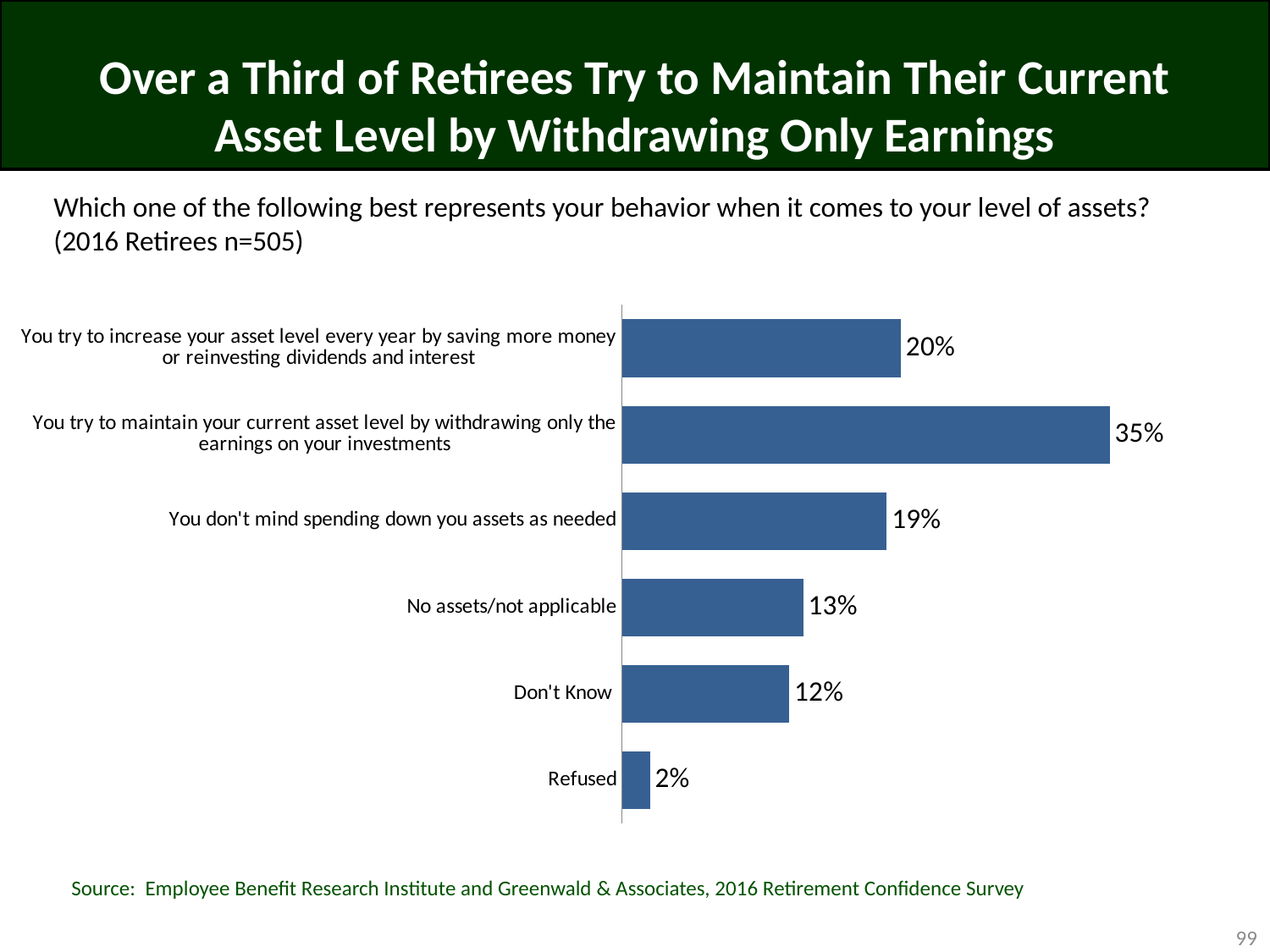
How many response categories are shown in the chart? 6 What percentage of retirees say they try to increase their asset level every year by saving more money or reinvesting dividends and interest? 20% What is the sample size of 2016 retirees stated on the slide? n=505 What percentage of retirees answered 'No assets/not applicable'? 13% Which response has the lowest percentage? Refused What percentage of retirees say they don't mind spending down their assets as needed? 19% Which is larger: the percentage for 'No assets/not applicable' or the percentage for 'Don't Know'? No assets/not applicable What percentage of retirees say they try to maintain their current asset level by withdrawing only the earnings on their investments? 35% What percentage of retirees answered 'Refused'? 2% What is the difference in percentage points between 'You try to maintain your current asset level by withdrawing only the earnings on your investments' and 'You try to increase your asset level every year by saving more money or reinvesting dividends and interest'? 15 percentage points Which response has the highest percentage? You try to maintain your current asset level by withdrawing only the earnings on your investments What type of chart is shown on the slide? Bar chart